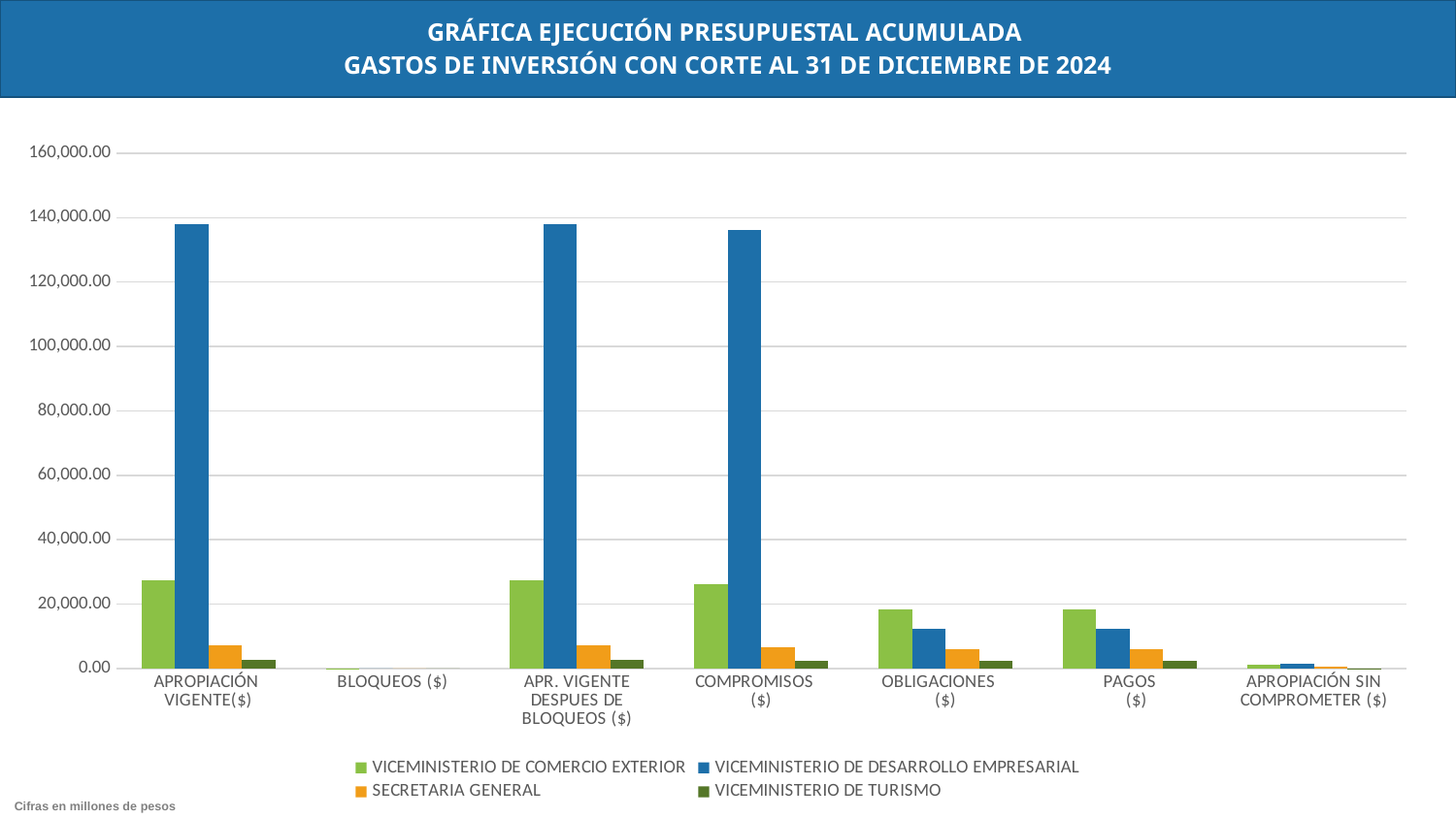
For VICEMINISTERIO DE DESARROLLO EMPRESARIAL, which is larger: COMPROMISOS ($) or PAGOS ($)? COMPROMISOS ($) How many series does the legend list? 4 Is the value for SECRETARIA GENERAL in COMPROMISOS ($) greater or less than 20,000.00? less Is the value for VICEMINISTERIO DE DESARROLLO EMPRESARIAL in OBLIGACIONES ($) greater or less than 20,000.00? less Which category shows no visible bars for any series? BLOQUEOS ($) Is the value for VICEMINISTERIO DE DESARROLLO EMPRESARIAL in APROPIACIÓN VIGENTE($) greater or less than 120,000.00? greater In the OBLIGACIONES ($) category, which is larger: VICEMINISTERIO DE COMERCIO EXTERIOR or VICEMINISTERIO DE DESARROLLO EMPRESARIAL? VICEMINISTERIO DE COMERCIO EXTERIOR How many categories are shown along the x axis? 7 Which series has the highest value in the APROPIACIÓN VIGENTE($) category? VICEMINISTERIO DE DESARROLLO EMPRESARIAL According to the note at the bottom left, in what units are the figures expressed? Millones de pesos What kind of chart is shown on the slide? Bar chart